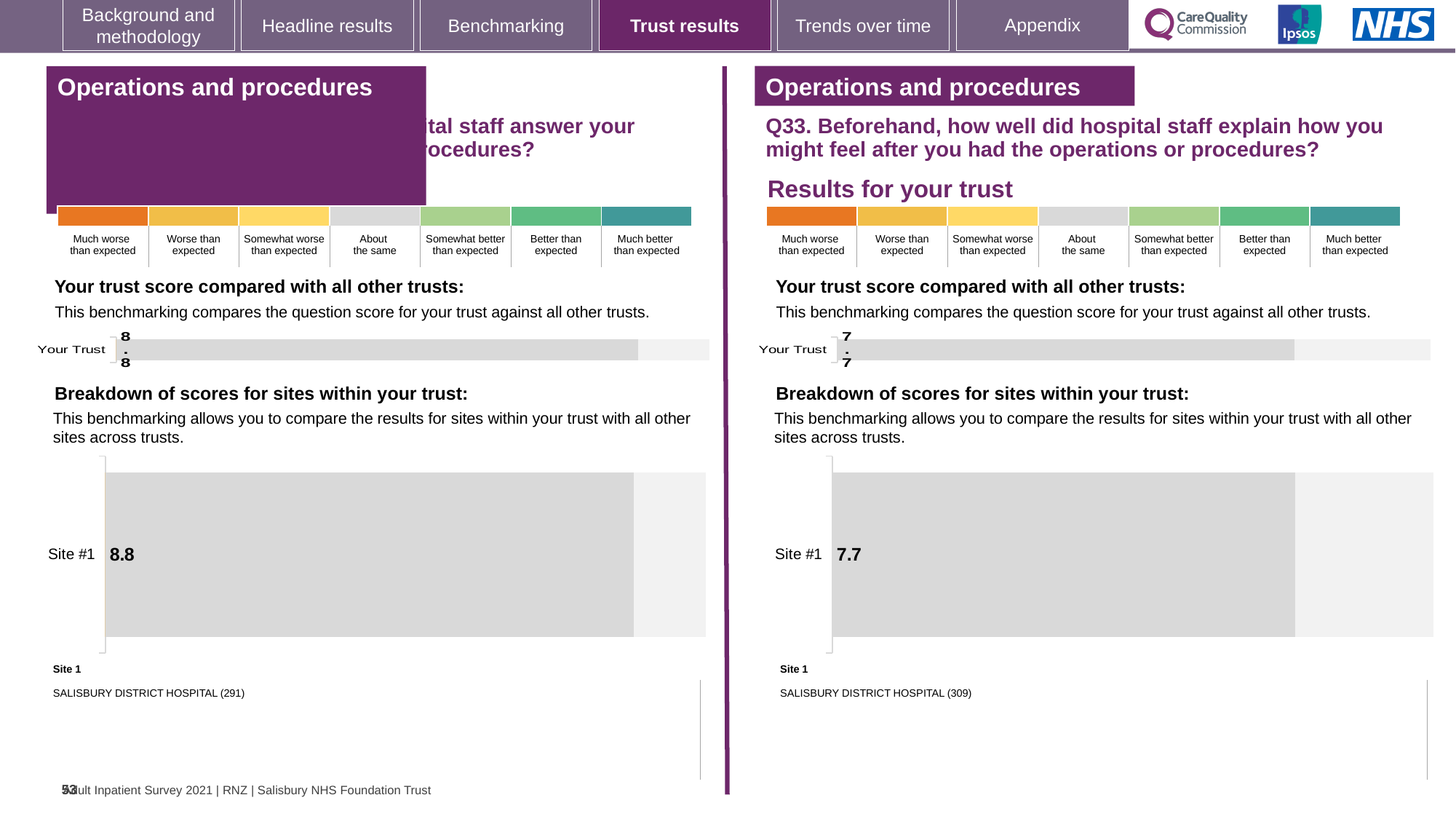
Which is larger: the Site #1 score on the left-hand panel or the Site #1 score on the right-hand panel (Q33)? Left-hand panel (8.8) On the left-hand panel, which site name is listed as Site 1 below the breakdown chart? SALISBURY DISTRICT HOSPITAL (291) Is the Your Trust score on the right-hand panel (Q33) greater or less than 8? less On the right-hand panel (Q33), what score is shown for Site #1 in the breakdown of scores for sites within your trust? 7.7 On the right-hand panel (Q33), what is the score shown for Your Trust? 7.7 On the right-hand panel (Q33), which site name is listed as Site 1 below the breakdown chart? SALISBURY DISTRICT HOSPITAL (309) How many sites are shown in the breakdown of scores chart on the right-hand panel (Q33)? 1 On the left-hand panel, what score is shown for Site #1 in the breakdown of scores for sites within your trust? 8.8 What type of chart is used to show the Site #1 score on the left-hand panel? Bar chart What is the difference between the Site #1 score on the left-hand panel (8.8) and the Site #1 score on the right-hand panel (7.7)? 1.1 Is the Your Trust score on the left-hand panel greater or less than 8? greater On the left-hand panel, what is the score shown for Your Trust? 8.8